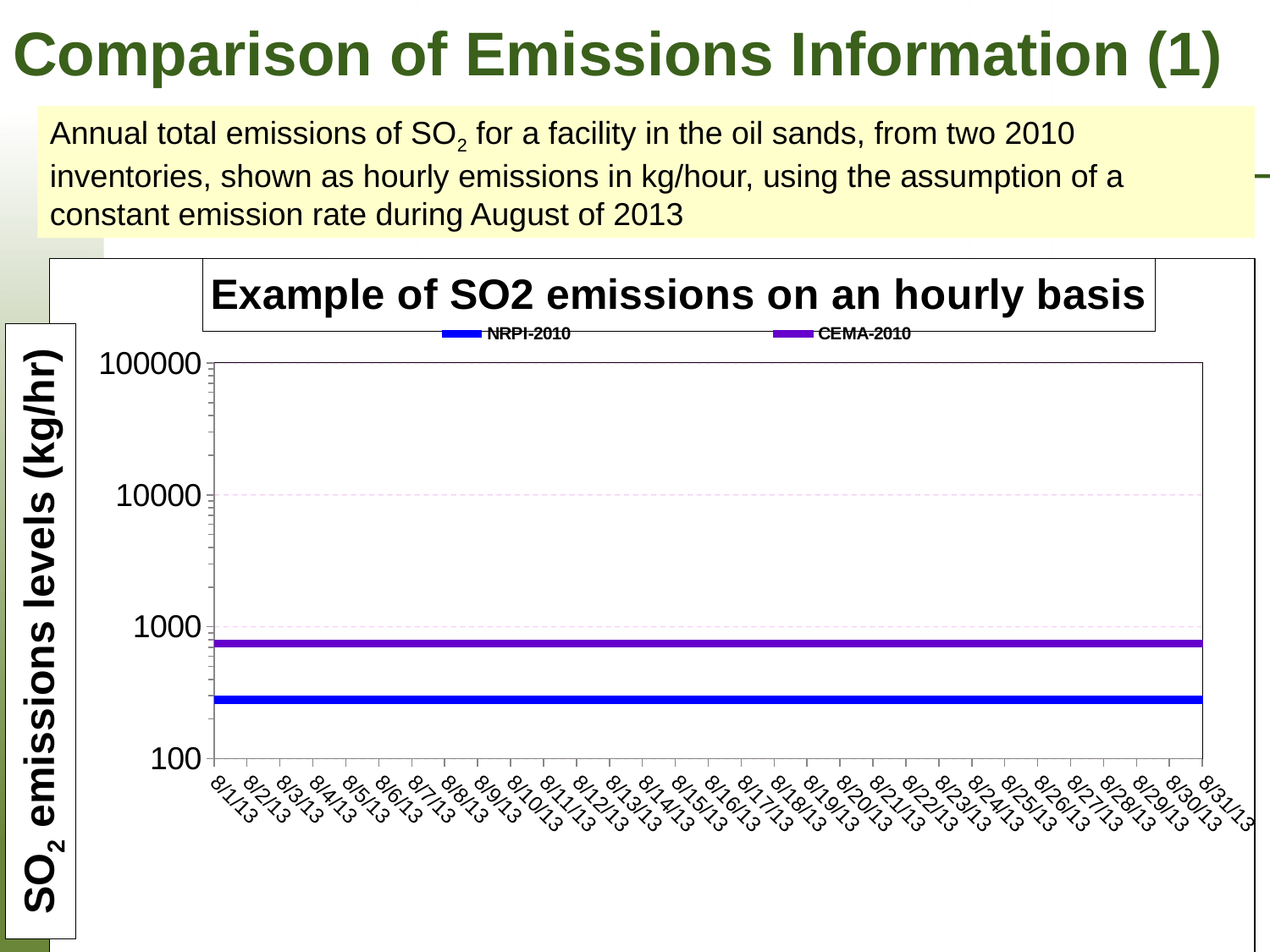
Is the value for CEMA-2010 greater or less than 1000 kg/hr? less Which series has the higher SO2 emissions level, NRPI-2010 or CEMA-2010? CEMA-2010 How many dates are shown on the x axis of the chart? 31 How many series does the chart legend list? 2 What is the title of the chart? Example of SO2 emissions on an hourly basis What colour is the line for the NRPI-2010 series? blue Is the value for NRPI-2010 greater or less than 100 kg/hr? greater What kind of chart is shown on the slide? line chart Is the value for NRPI-2010 greater or less than 1000 kg/hr? less Do the NRPI-2010 values rise, fall, or stay constant across the dates on the x axis? stay constant Do the CEMA-2010 values rise, fall, or stay constant across the dates on the x axis? stay constant